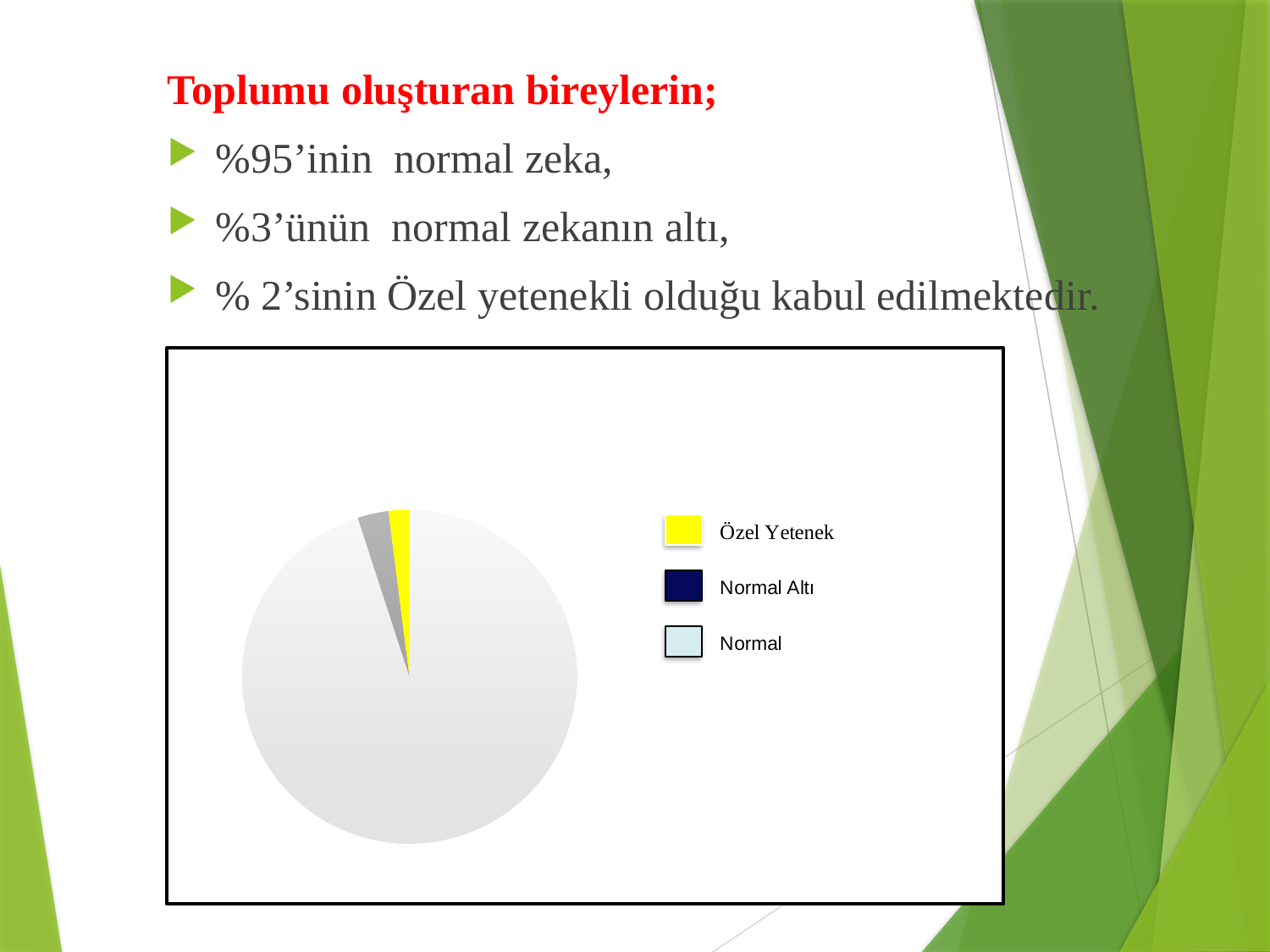
Which category has the largest slice in the pie chart? Normal Which category is shown in yellow in the pie chart? Özel Yetenek How many slices does the pie chart have? 3 What kind of chart is shown on the slide? pie chart Which slice is larger in the pie chart, Normal or Normal Altı? Normal How many entries does the legend of the pie chart list? 3 Which legend entry is listed first in the pie chart's legend? Özel Yetenek Which slice is larger in the pie chart, Normal or Özel Yetenek? Normal